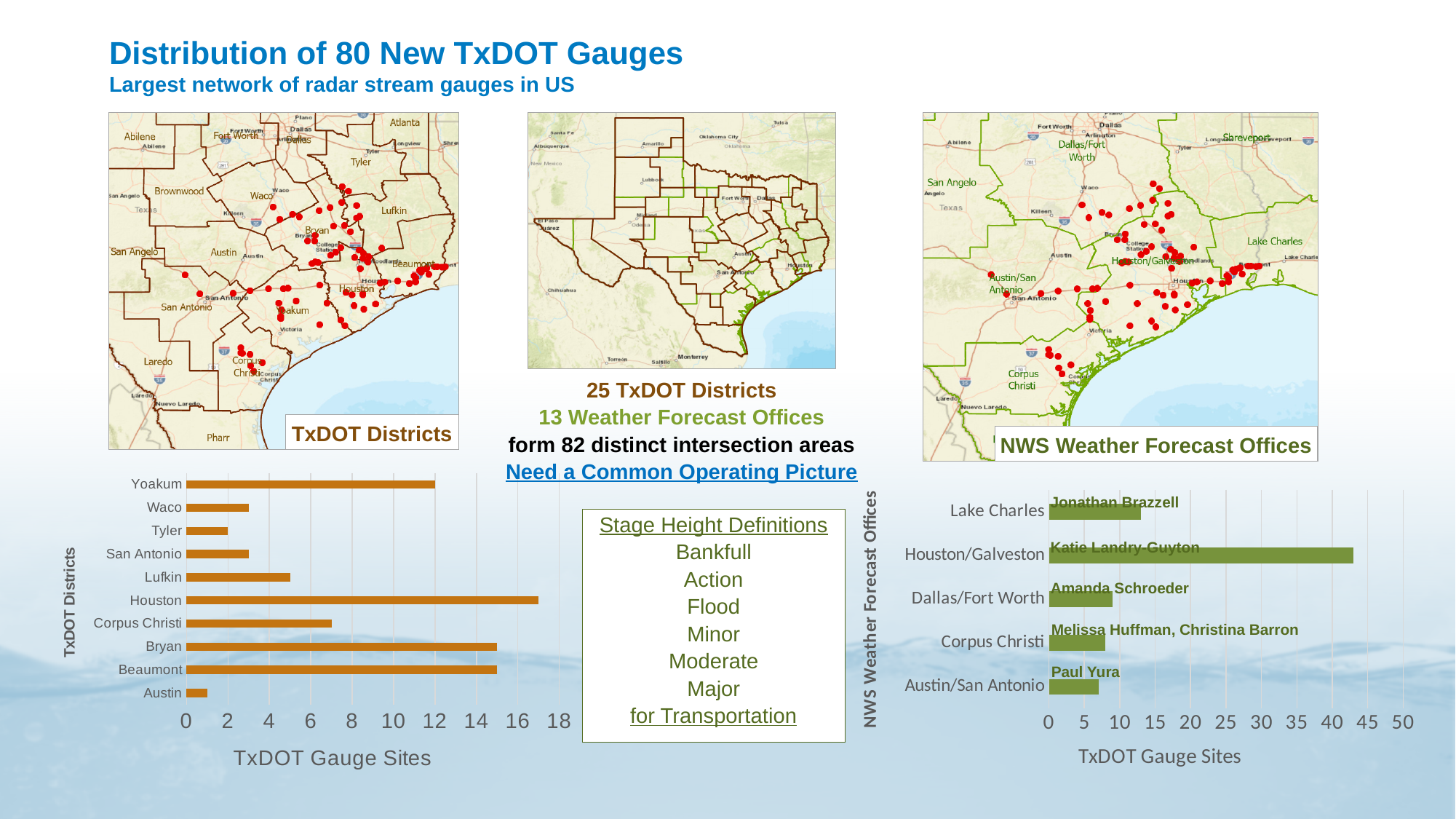
In the bottom-right chart of NWS Weather Forecast Offices, which has more TxDOT gauge sites, Lake Charles or Dallas/Fort Worth? Lake Charles In the bottom-left chart of TxDOT Districts, which district has the lowest number of TxDOT gauge sites? Austin In the bottom-left chart of TxDOT Districts, which district has the highest number of TxDOT gauge sites? Houston In the bottom-left chart of TxDOT Districts, which has more TxDOT gauge sites, Houston or Yoakum? Houston How many weather forecast offices are listed in the bottom-right NWS Weather Forecast Offices bar chart? 5 What kind of chart is the chart at the bottom left of the slide? bar chart What is the x-axis title of the bottom-left TxDOT Districts bar chart? TxDOT Gauge Sites How many districts are listed in the bottom-left TxDOT Districts bar chart? 10 In the bottom-right chart of NWS Weather Forecast Offices, which office has the highest number of TxDOT gauge sites? Houston/Galveston In the bottom-left chart of TxDOT Districts, is the value for Houston greater or less than 16? greater In the bottom-left chart of TxDOT Districts, is the value for Corpus Christi greater or less than 8? less In the bottom-right chart of NWS Weather Forecast Offices, is the value for Houston/Galveston greater or less than 40? greater